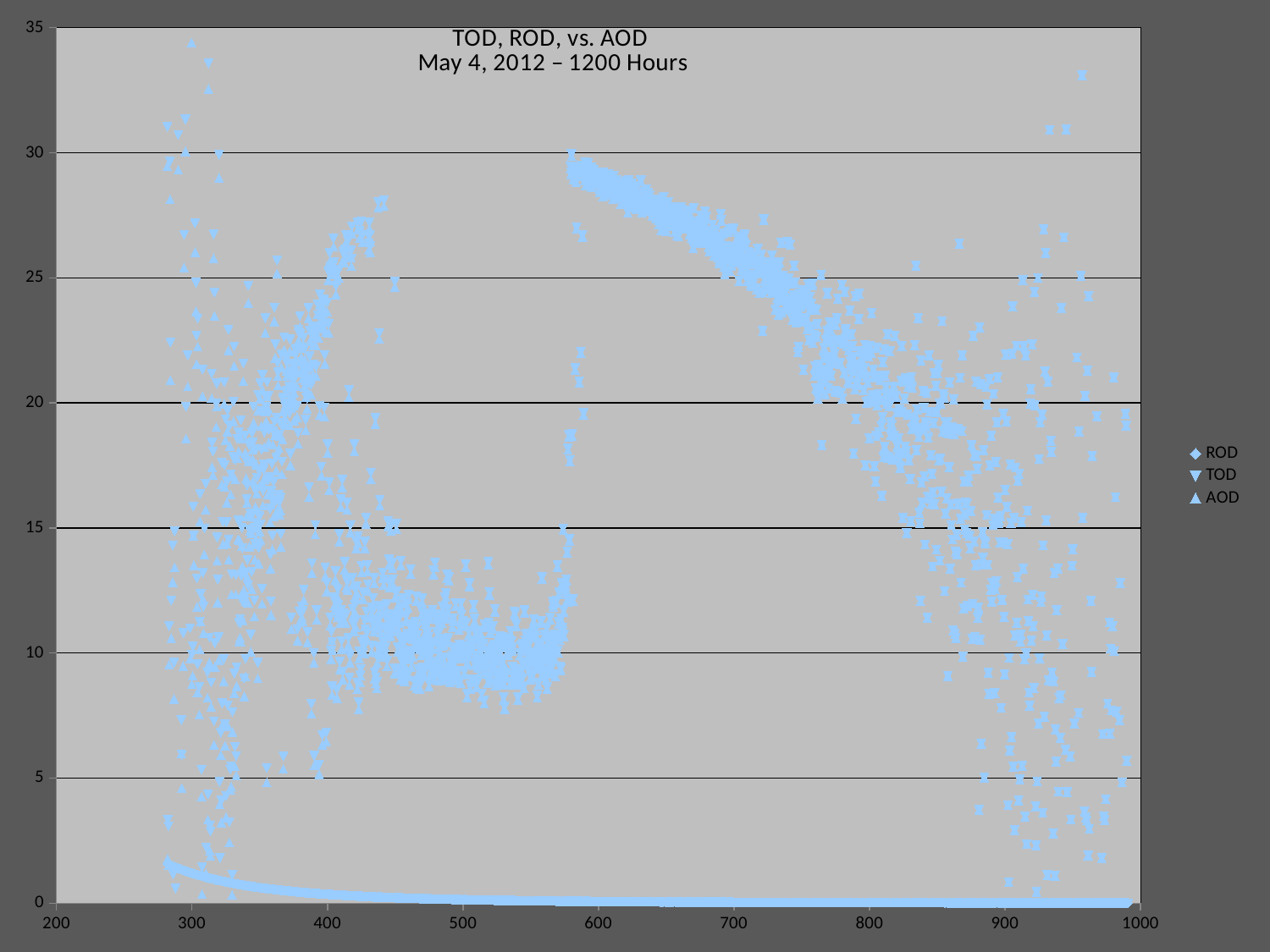
How many series does the legend list? 3 Are the values of the smooth curve of points running along the bottom of the chart greater or less than 5? less What date and time appear in the chart title? May 4, 2012 – 1200 Hours What kind of chart is shown on the slide? scatter chart Is the highest point plotted on the chart greater or less than 30? greater What are the three series named in the legend? ROD, TOD, AOD